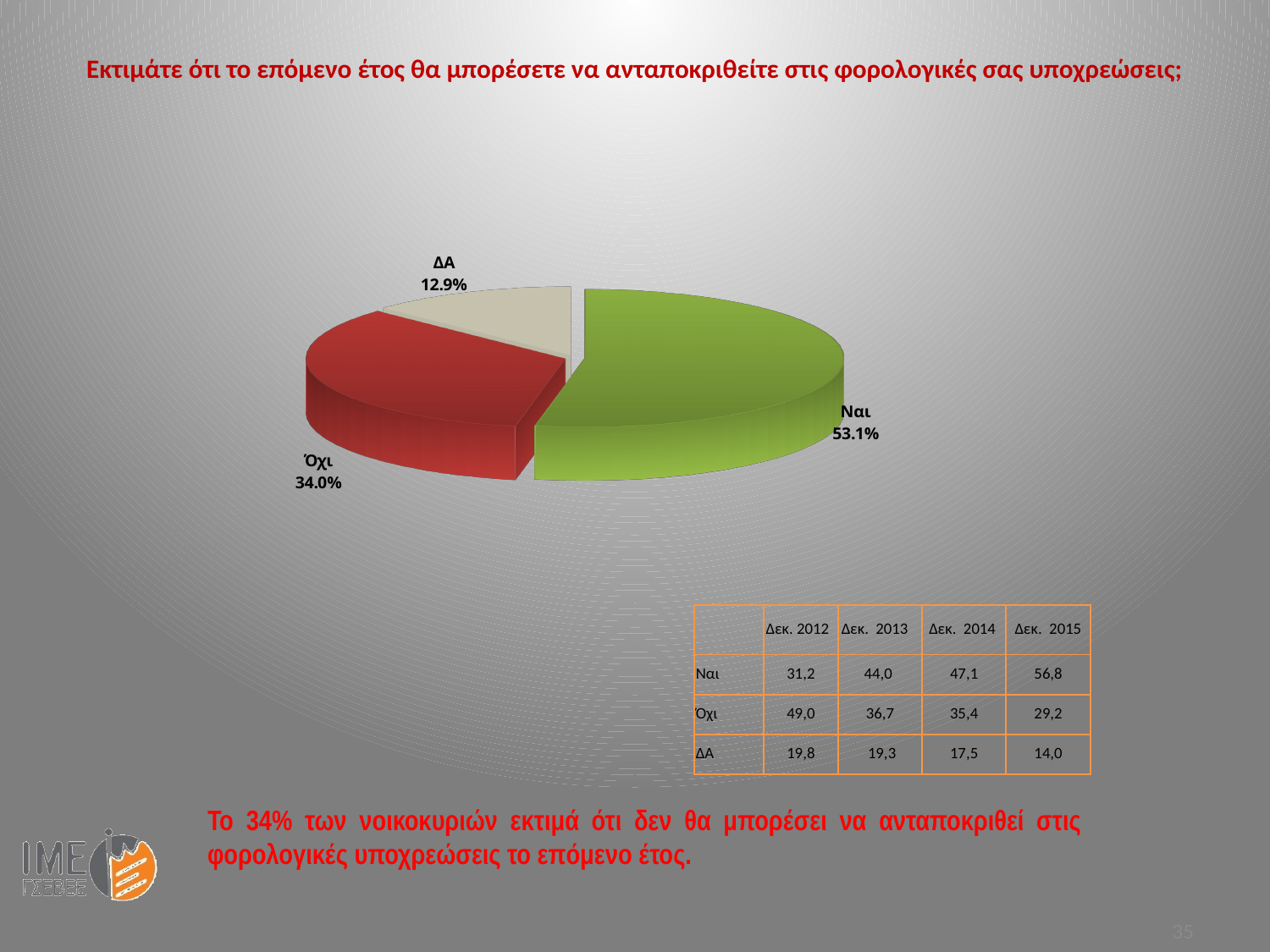
What is the value shown for the ΔΑ slice in the pie chart? 12.9% How many slices does the pie chart have? 3 What share of the pie does the Ναι slice represent? 53.1% Which slice of the pie chart is the largest? Ναι What kind of chart is shown on the slide? pie chart What is the difference in percentage points between the Ναι and Όχι slices? 19.1 What colour is the Όχι slice in the pie chart? red What is the value shown for the Όχι slice in the pie chart? 34.0% Which is larger in the pie chart, Όχι or ΔΑ? Όχι Which slice of the pie chart is the smallest? ΔΑ What is the value shown for the Ναι slice in the pie chart? 53.1% What is the difference in percentage points between the Όχι and ΔΑ slices? 21.1